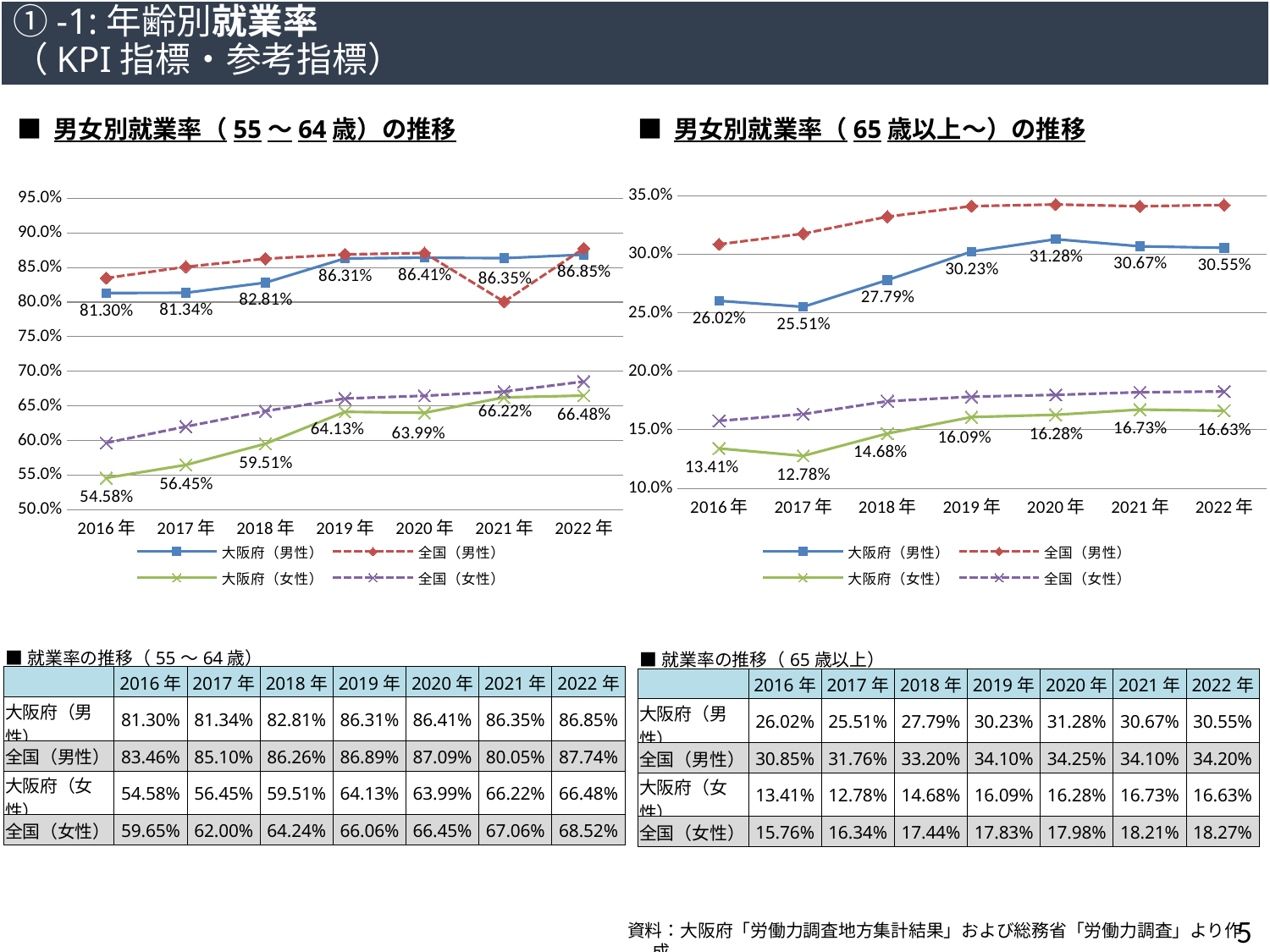
In the left chart (男女別就業率（55～64歳）の推移), what is the value for 大阪府（男性） in 2016年? 81.30% In the left chart (男女別就業率（55～64歳）の推移), what is the difference between the 大阪府（男性） values for 2022年 and 2016年? 5.55% In the left chart (男女別就業率（55～64歳）の推移), which year has the lowest value for 大阪府（女性）? 2016年 In the right chart (男女別就業率（65歳以上～）の推移), what is the value for 大阪府（男性） in 2020年? 31.28% In the right chart (男女別就業率（65歳以上～）の推移), which year has the highest value for 大阪府（男性）? 2020年 In the right chart (男女別就業率（65歳以上～）の推移), is the value for 全国（男性） in 2016年 greater or less than 30.0%? greater How many series does the legend of the left chart (男女別就業率（55～64歳）の推移) list? 4 In the right chart (男女別就業率（65歳以上～）の推移), what is the value for 大阪府（女性） in 2017年? 12.78% What kind of chart is the right chart (男女別就業率（65歳以上～）の推移)? line chart In the right chart (男女別就業率（65歳以上～）の推移), what is the difference between the 大阪府（女性） values for 2021年 and 2016年? 3.32% In the left chart (男女別就業率（55～64歳）の推移), what is the value for 大阪府（女性） in 2022年? 66.48% In the left chart (男女別就業率（55～64歳）の推移), which is larger in 2021年: 大阪府（男性） or 全国（男性）? 大阪府（男性）